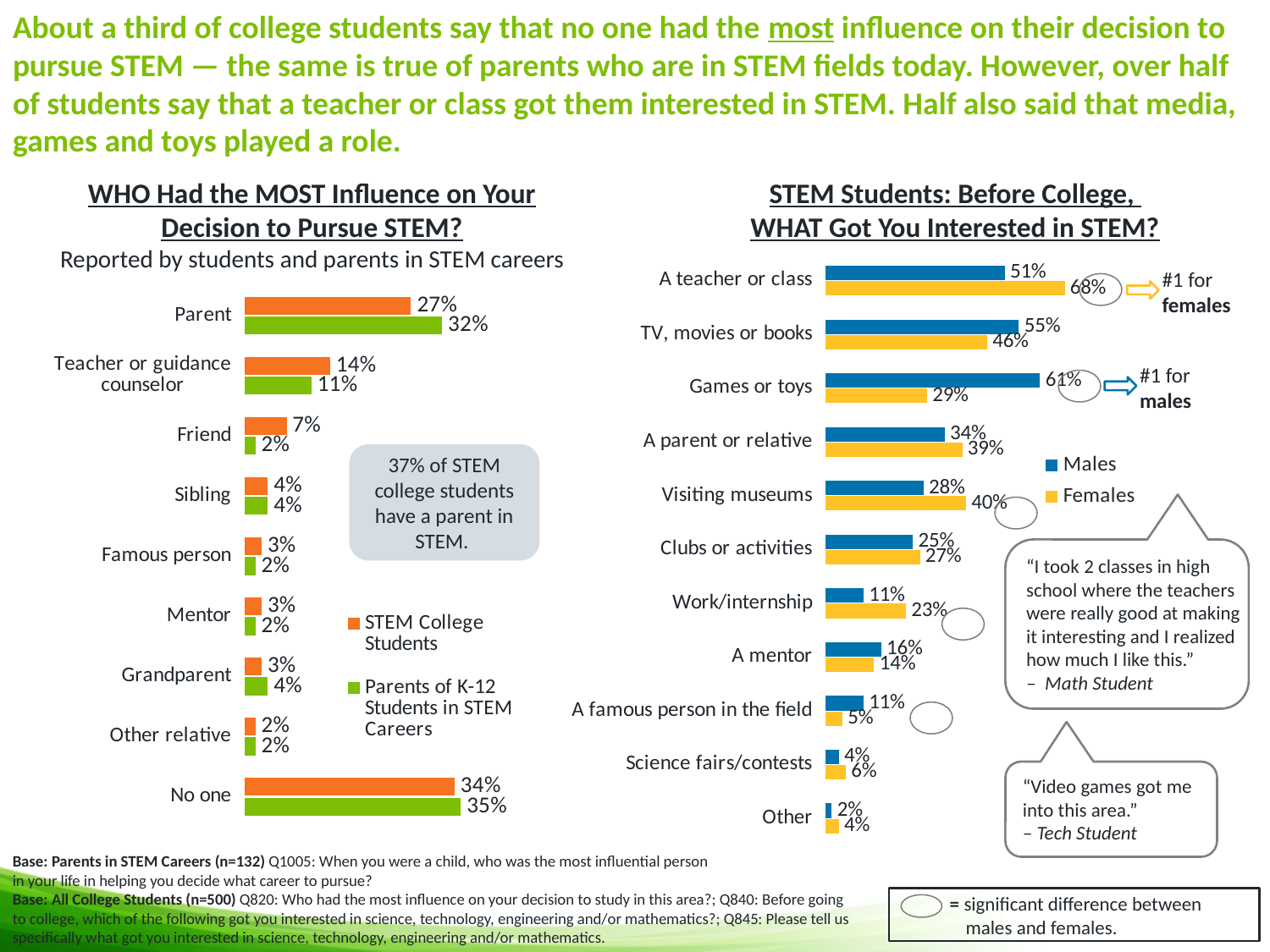
In the chart 'STEM Students: Before College, WHAT Got You Interested in STEM?', which category has the highest value for Males? Games or toys In the chart 'WHO Had the MOST Influence on Your Decision to Pursue STEM?', what percentage of STEM College Students chose 'No one'? 34% How many categories are shown in the chart 'WHO Had the MOST Influence on Your Decision to Pursue STEM?'? 9 In the chart 'STEM Students: Before College, WHAT Got You Interested in STEM?', what is the difference between Males and Females for 'Games or toys'? 32% What type of chart is 'WHO Had the MOST Influence on Your Decision to Pursue STEM?'? Bar chart How many series does the legend list in the chart 'STEM Students: Before College, WHAT Got You Interested in STEM?'? 2 In the chart 'STEM Students: Before College, WHAT Got You Interested in STEM?', what percentage of Females chose 'A teacher or class'? 68% In the chart 'STEM Students: Before College, WHAT Got You Interested in STEM?', which is larger for 'Visiting museums', Males or Females? Females In the chart 'STEM Students: Before College, WHAT Got You Interested in STEM?', what percentage of Males chose 'Games or toys'? 61% In the chart 'WHO Had the MOST Influence on Your Decision to Pursue STEM?', which category has the highest value for STEM College Students? No one In the chart 'WHO Had the MOST Influence on Your Decision to Pursue STEM?', what is the difference between STEM College Students and Parents of K-12 Students in STEM Careers for 'Friend'? 5% In the chart 'WHO Had the MOST Influence on Your Decision to Pursue STEM?', what is the value for Parents of K-12 Students in STEM Careers for 'Parent'? 32%